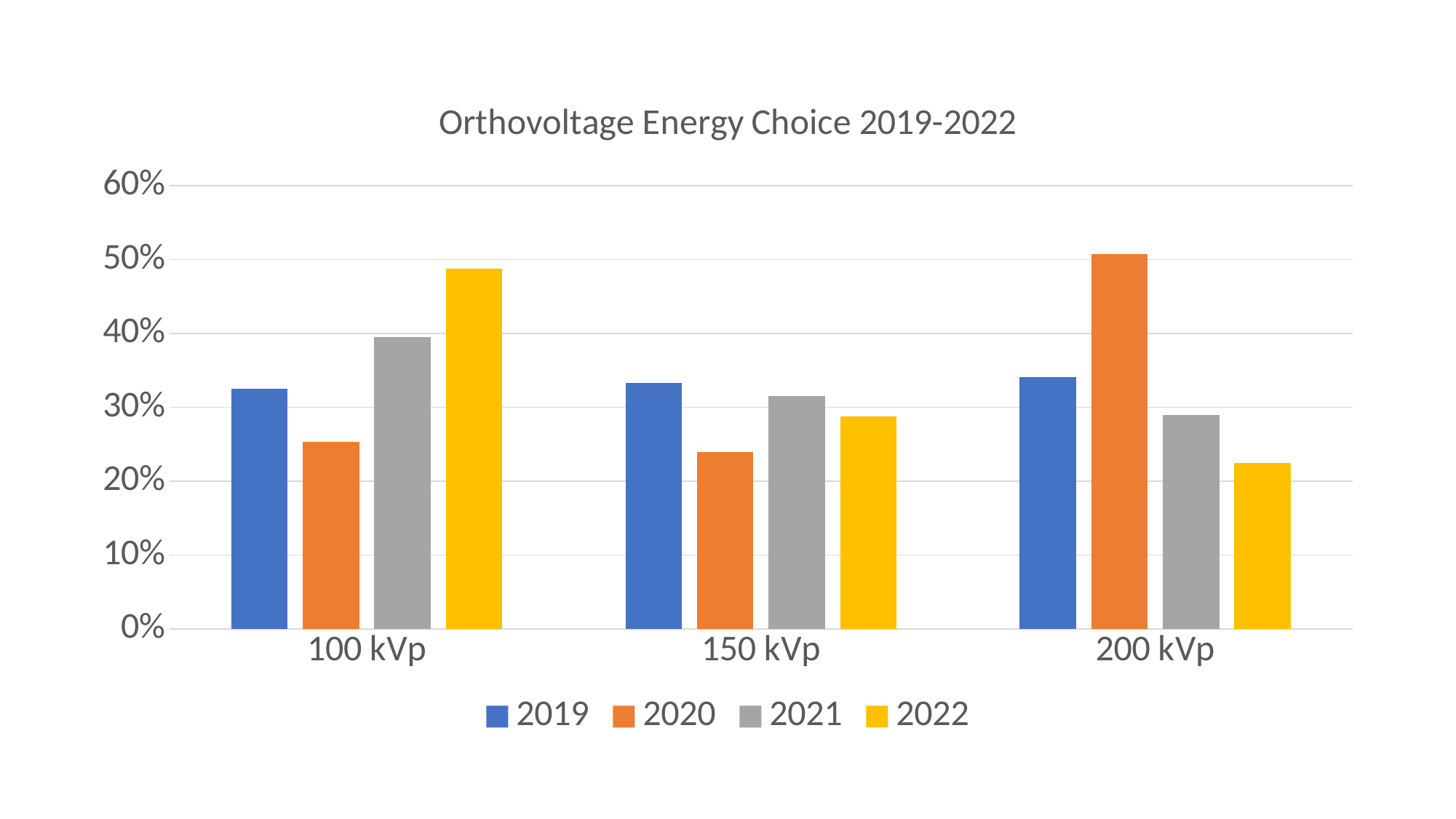
How many series does the legend list? 4 How many energy categories are shown on the x axis? 3 What kind of chart is shown on the slide? bar chart What is the title of the chart? Orthovoltage Energy Choice 2019-2022 Which year has the lowest value for 100 kVp? 2020 Which year has the lowest value for 200 kVp? 2022 Which year has the highest value for 200 kVp? 2020 Do the values for the 2022 series rise or fall from 100 kVp to 200 kVp? fall Is the value for 2020 at 150 kVp greater or less than 30%? less Is the value for 2022 at 100 kVp greater or less than 40%? greater Which year has the highest value for 100 kVp? 2022 Which is larger: the 2022 value for 100 kVp or the 2022 value for 200 kVp? 100 kVp